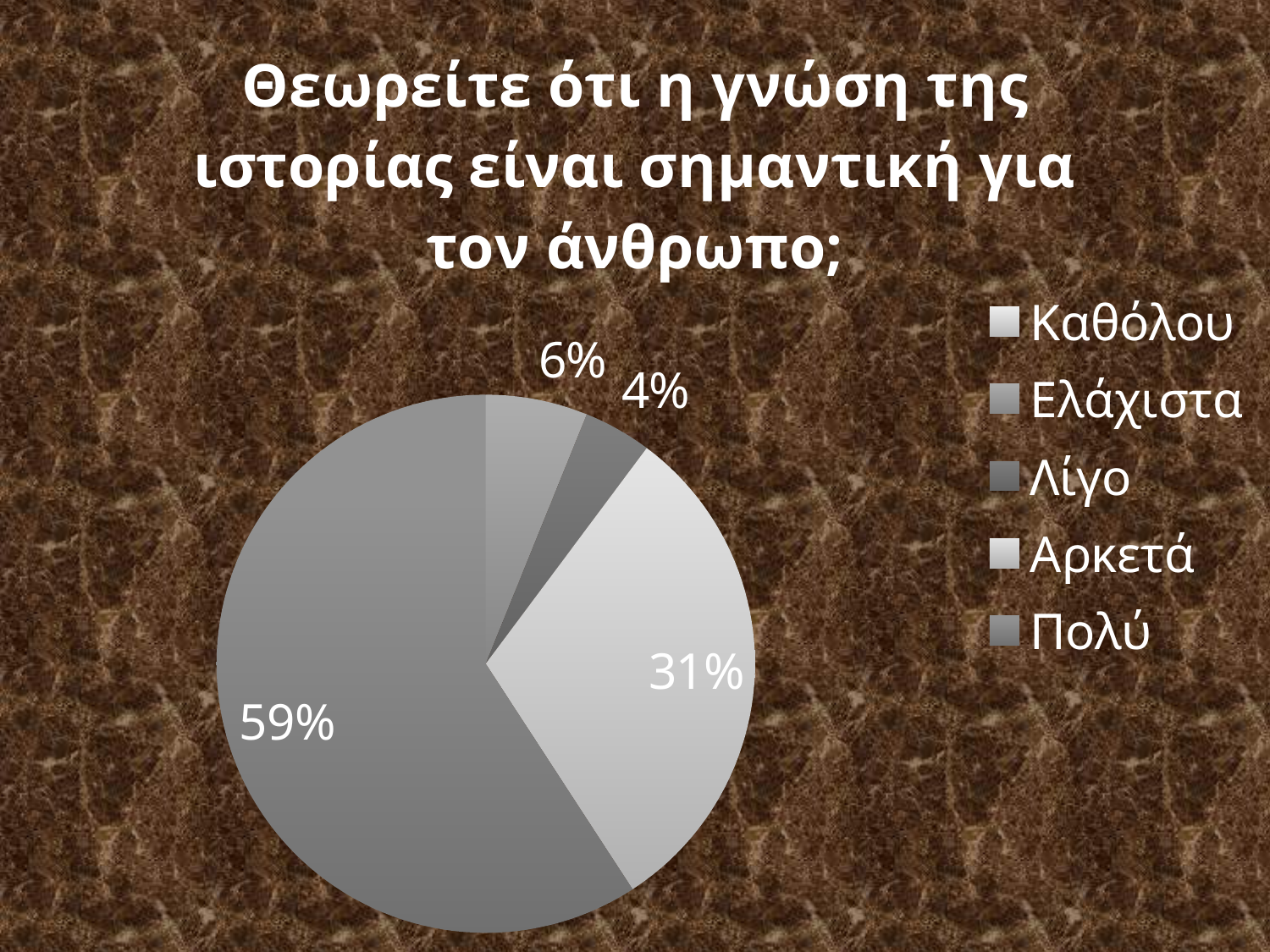
What is the difference in percentage points between the Πολύ slice and the Αρκετά slice? 28 What is the first entry listed in the legend of the pie chart? Καθόλου Which category has the largest share of the pie chart? Πολύ What share of the pie does the Αρκετά slice represent? 31% What is the combined share of the Πολύ and Αρκετά slices? 90% What share of the pie does the Λίγο slice represent? 4% Which slice is larger, Ελάχιστα or Λίγο? Ελάχιστα How many entries does the legend of the pie chart list? 5 What kind of chart is shown on the slide? pie chart What share of the pie does the Ελάχιστα slice represent? 6% What percentage is shown for the largest slice of the pie chart? 59% Which slice is larger, Αρκετά or Πολύ? Πολύ